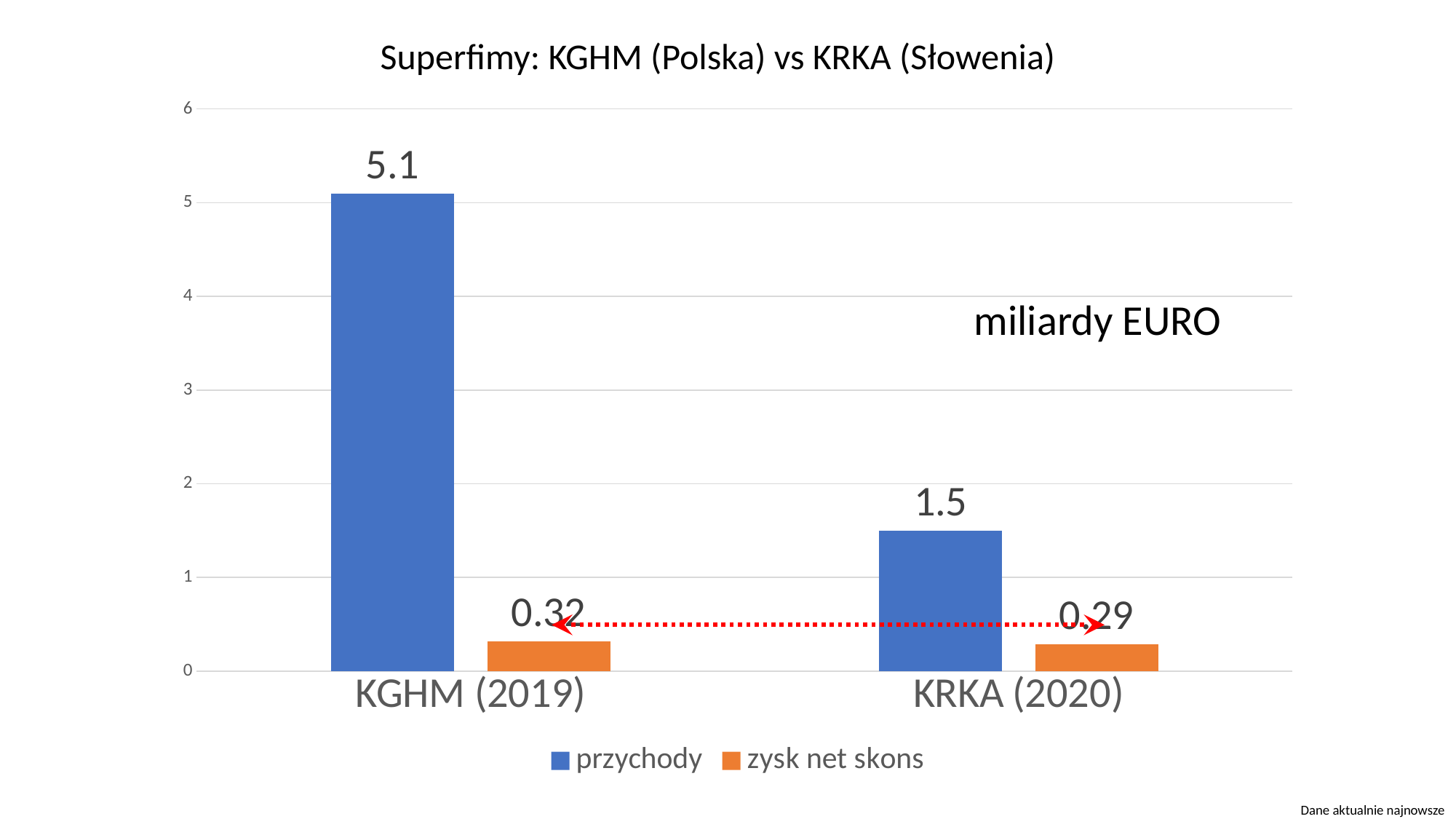
What is the przychody value for KRKA (2020)? 1.5 What is the difference between the przychody values of KGHM (2019) and KRKA (2020)? 3.6 How many series does the legend list? 2 Is the przychody value for KGHM (2019) greater or less than 5? greater What kind of chart is shown on the slide? bar chart What is the zysk net skons value for KGHM (2019)? 0.32 Which company has the higher przychody value? KGHM (2019) What is the zysk net skons value for KRKA (2020)? 0.29 What is the title of the chart? Superfimy: KGHM (Polska) vs KRKA (Słowenia) Which company has the lower zysk net skons value? KRKA (2020) What is the difference between the zysk net skons values of KGHM (2019) and KRKA (2020)? 0.03 What is the przychody value for KGHM (2019)? 5.1